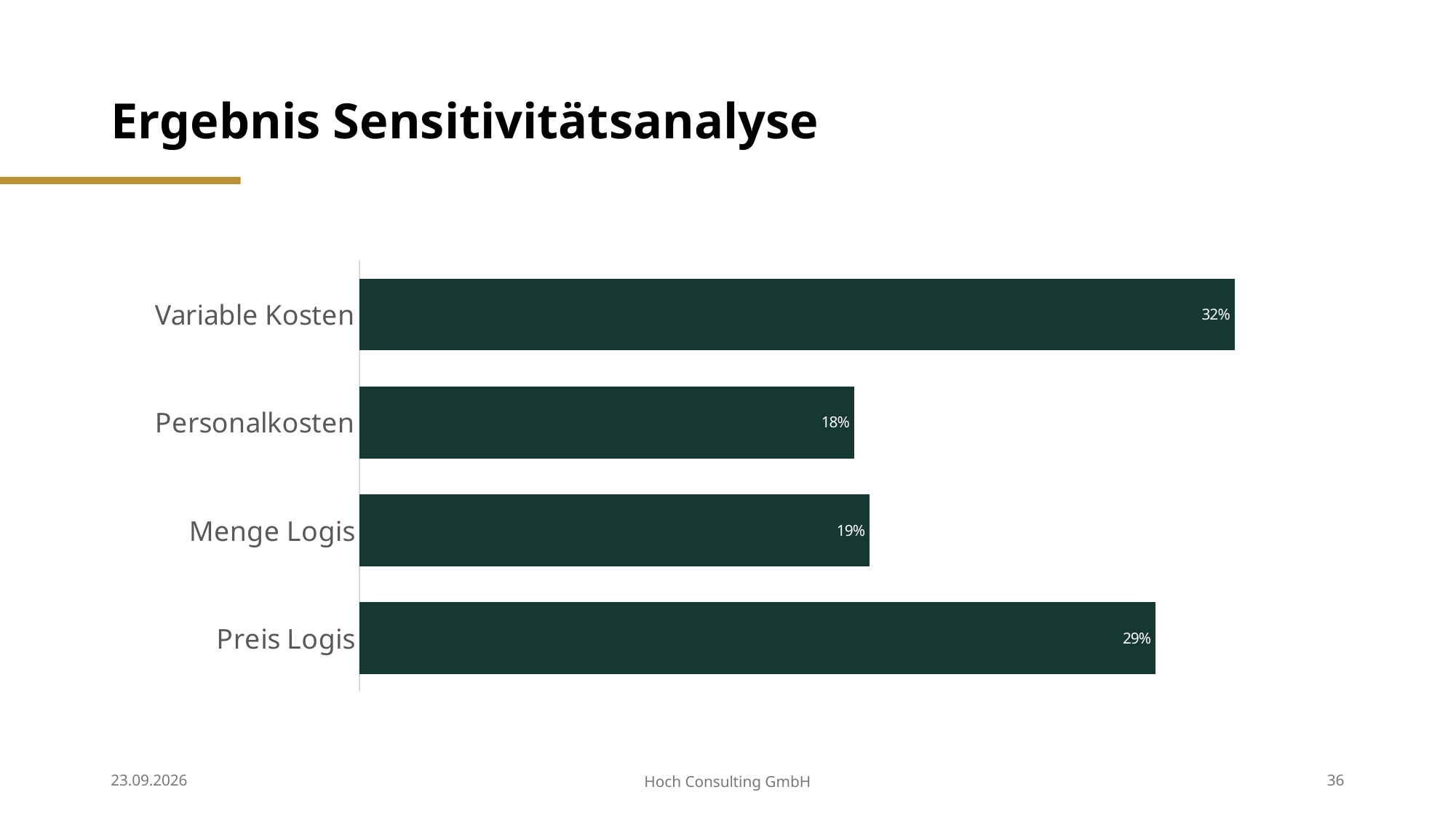
What is the title of the slide containing the chart? Ergebnis Sensitivitätsanalyse How many categories are shown in the chart? 4 What is the value for Menge Logis? 19% What is the difference between the values for Menge Logis and Personalkosten? 1% What is the value for Variable Kosten? 32% Which category has the highest value? Variable Kosten What is the difference between the values for Variable Kosten and Preis Logis? 3% Which category has the lowest value? Personalkosten Which is larger, the value for Preis Logis or the value for Personalkosten? Preis Logis What kind of chart is shown on the slide? Bar chart What is the value for Personalkosten? 18% What is the value for Preis Logis? 29%